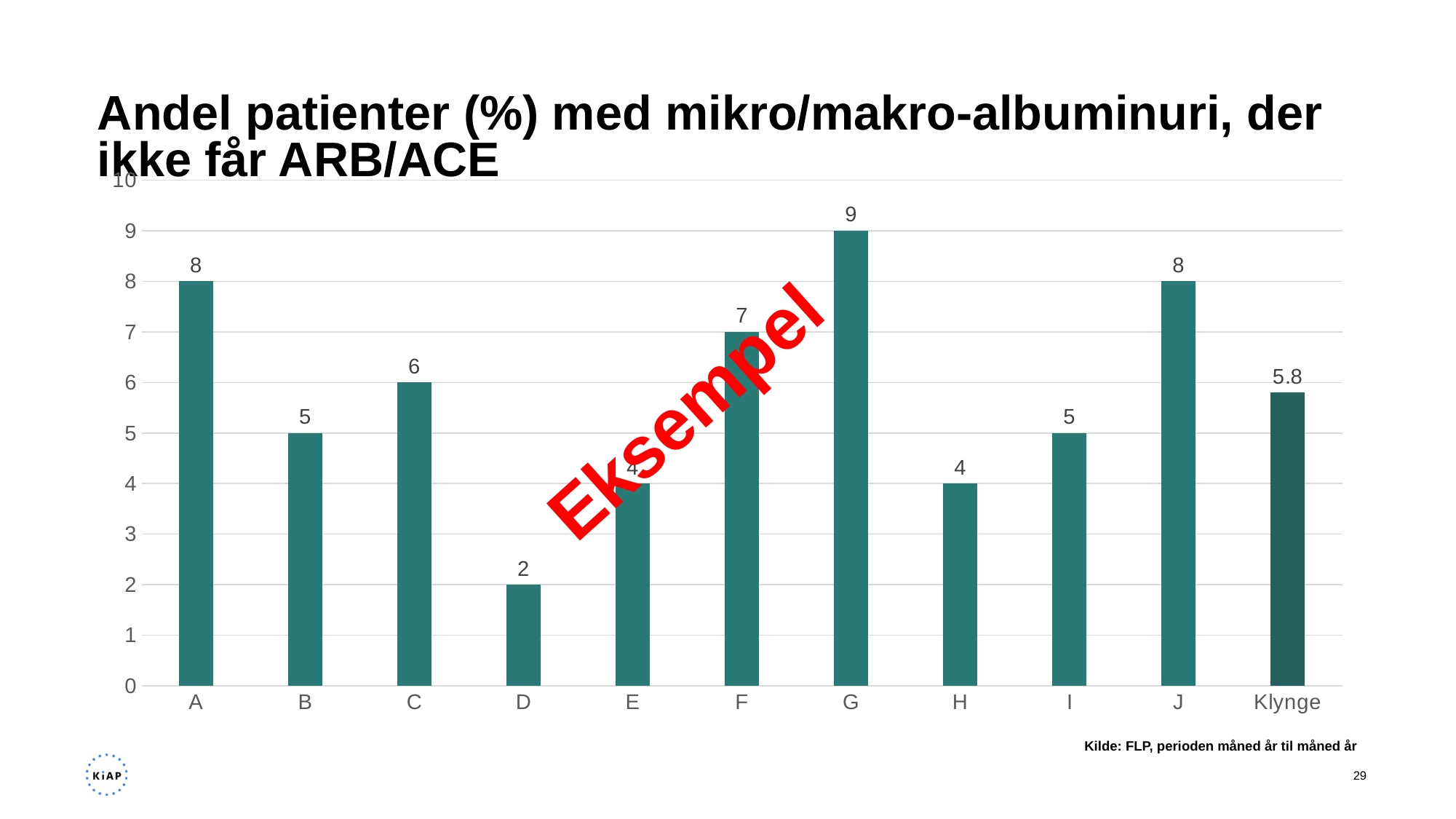
Which category has the lowest value? D What is the value for Klynge? 5.8 What is the title of the chart? Andel patienter (%) med mikro/makro-albuminuri, der ikke får ARB/ACE What kind of chart is this? bar chart How many categories are shown on the x axis? 11 Is the value for F greater or less than 5? greater Which is larger, the value for C or the value for H? C What is the difference between the values for G and D? 7 What is the value for category D? 2 Which category has the highest value? G What red word is stamped diagonally across the chart? Eksempel What is the value for category G? 9